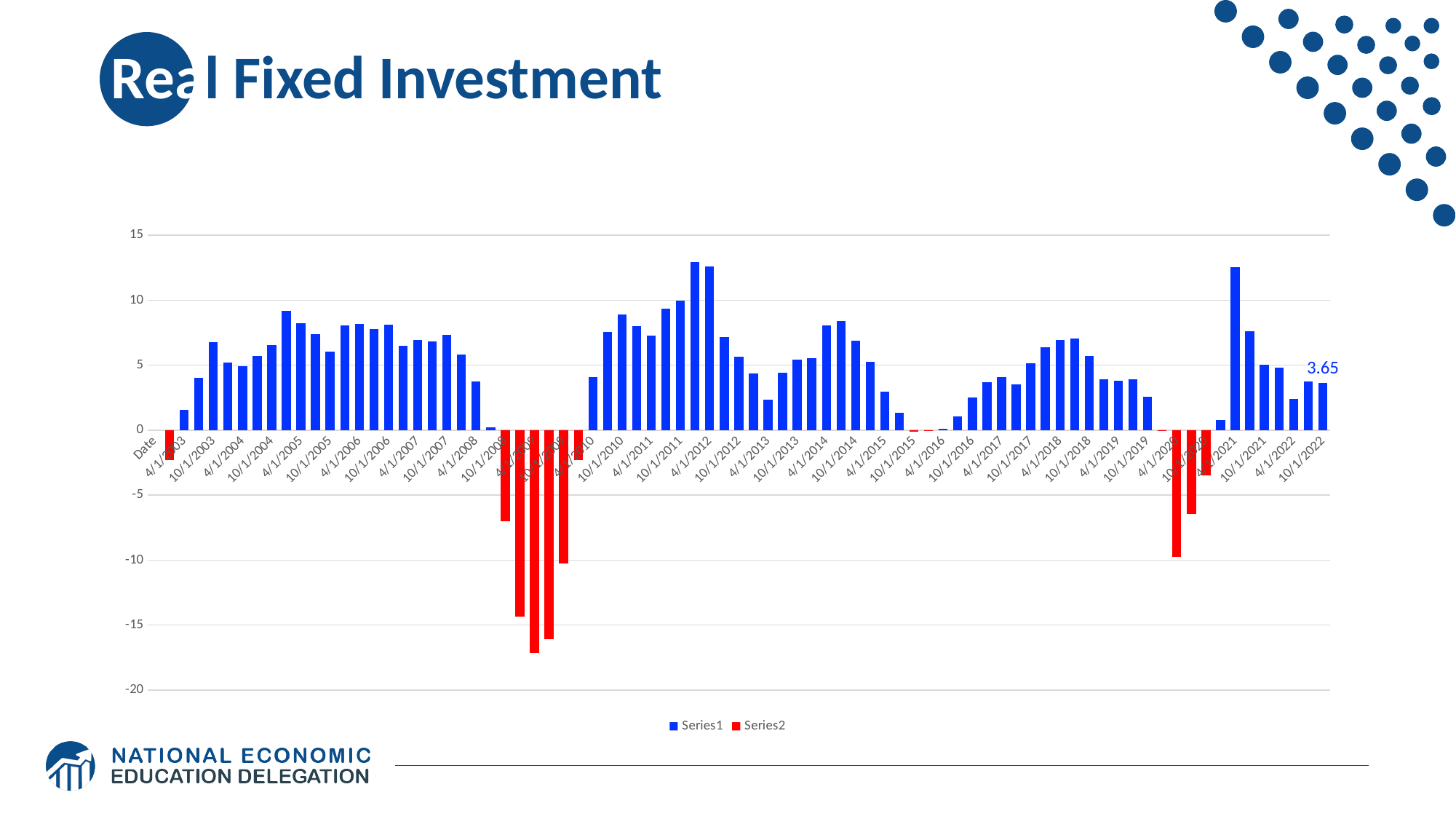
Is the value for 4/1/2005 greater or less than 5? greater Which is larger, the value for 4/1/2012 or the value for 4/1/2003? 4/1/2012 What is the value shown by the data label on the last bar (10/1/2022)? 3.65 In which year does the lowest bar on the chart occur? 2009 What are the two entries in the chart legend? Series1 and Series2 How many series does the legend list? 2 Is the value for 4/1/2022 greater or less than 5? less What kind of chart is shown on the slide? bar chart Is the value for 4/1/2012 greater or less than 10? greater What colour are the Series2 bars? red